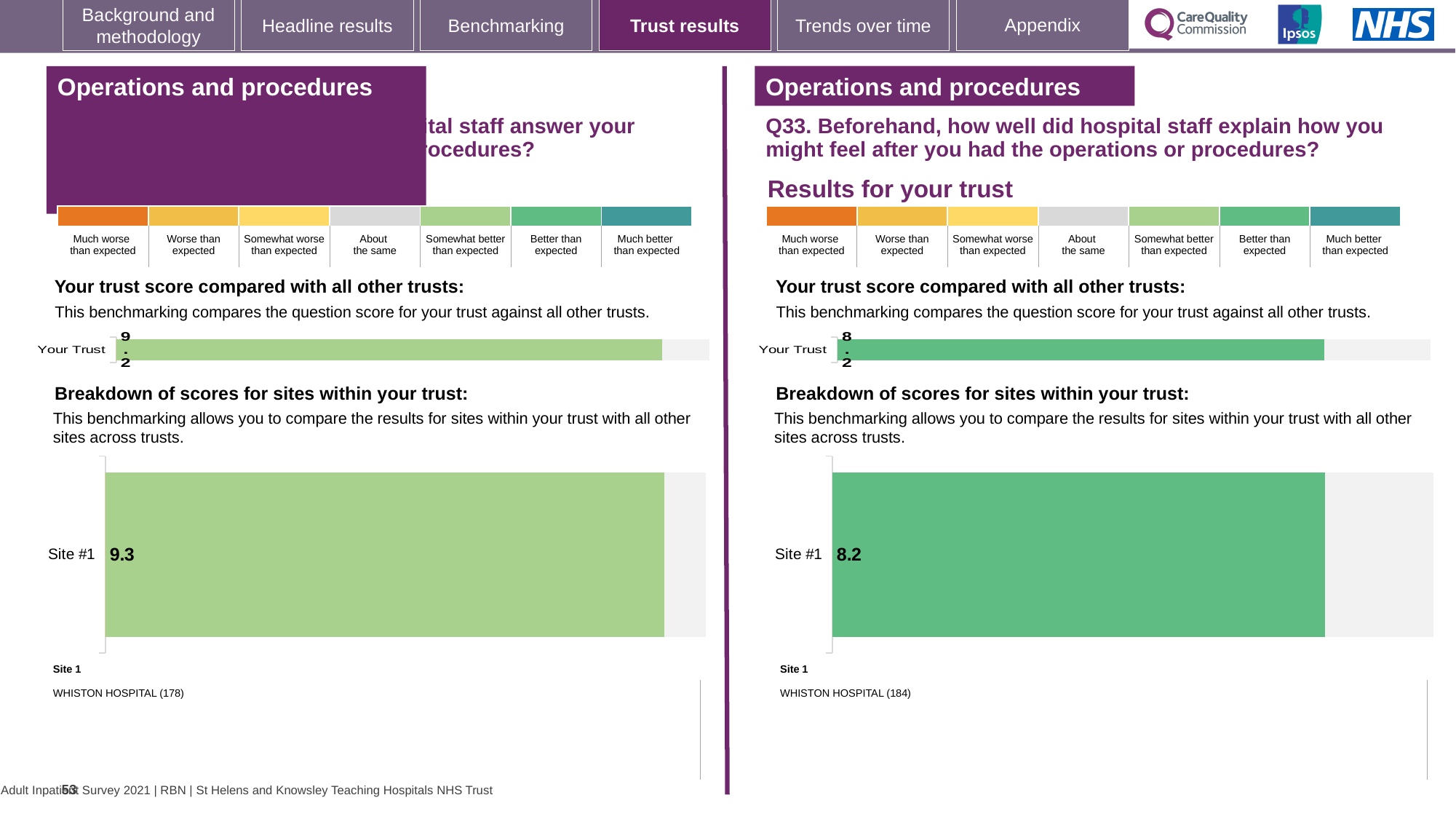
On the left-hand side of the slide, which site name is listed as Site 1 below the chart? WHISTON HOSPITAL (178) On the left-hand side of the slide, what is the score shown for Site #1 in the 'Breakdown of scores for sites within your trust' chart? 9.3 On the right-hand side of the slide (Q33), which site name is listed as Site 1 below the chart? WHISTON HOSPITAL (184) What is the difference between the Site #1 score on the left-hand side of the slide (9.3) and the Site #1 score on the right-hand side (8.2)? 1.1 Which is larger: the Site #1 score on the left-hand side of the slide or the Site #1 score on the right-hand side (Q33)? Left-hand side (9.3) How many sites are shown in the 'Breakdown of scores for sites within your trust' chart on the right-hand side of the slide (Q33)? 1 On the right-hand side of the slide (Q33), what is the score shown for 'Your Trust' in the 'Your trust score compared with all other trusts' chart? 8.2 On the left-hand side of the slide, what is the score shown for 'Your Trust' in the 'Your trust score compared with all other trusts' chart? 9.2 On the right-hand side of the slide (Q33), what is the score shown for Site #1 in the 'Breakdown of scores for sites within your trust' chart? 8.2 What type of chart is used to show the Site #1 score on the right-hand side of the slide (Q33)? Bar chart On the left-hand side of the slide, what is the difference between the Site #1 score (9.3) and the 'Your Trust' score (9.2)? 0.1